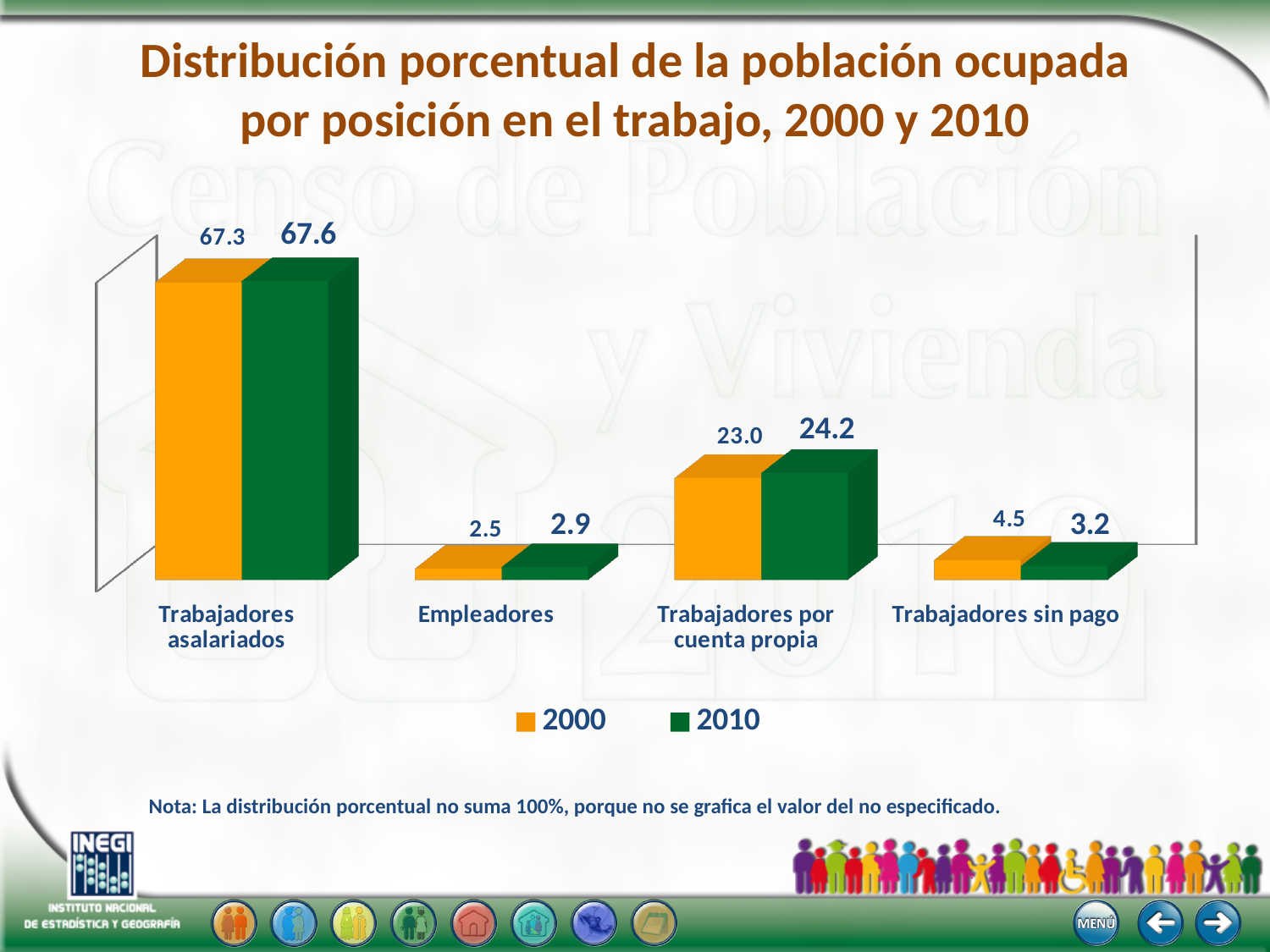
Which category has the highest value in 2010? Trabajadores asalariados What kind of chart is shown on the slide? Bar chart What is the value for Trabajadores asalariados in 2000? 67.3 What is the value for Trabajadores sin pago in 2000? 4.5 Which is larger for Trabajadores sin pago, the 2000 value or the 2010 value? 2000 Which category has the lowest value in 2000? Empleadores What is the difference between the 2010 and 2000 values for Trabajadores por cuenta propia? 1.2 How many categories are shown on the x axis? 4 What is the value for Trabajadores por cuenta propia in 2010? 24.2 What is the value for Empleadores in 2010? 2.9 Which colour represents the year 2010 in the legend? Green How many series does the legend list? 2